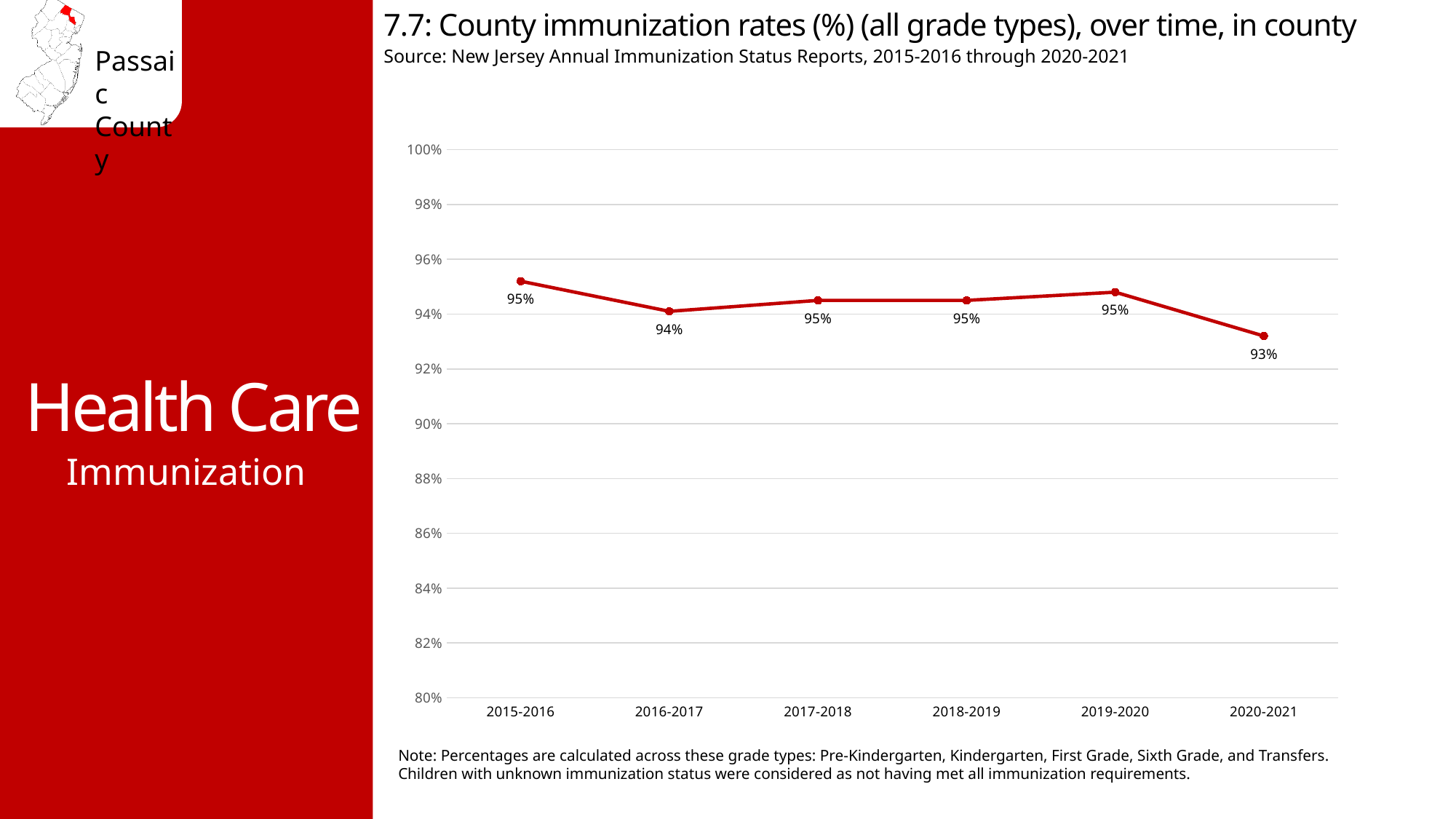
What is the county immunization rate for 2015-2016? 95% What is the source cited for the chart data? New Jersey Annual Immunization Status Reports, 2015-2016 through 2020-2021 How many school years are plotted on the chart? 6 Which school year has the lowest immunization rate? 2020-2021 What is the county immunization rate for 2018-2019? 95% Which year has a higher immunization rate, 2016-2017 or 2020-2021? 2016-2017 What is the difference in percentage points between the 2015-2016 rate and the 2020-2021 rate? 2 percentage points What is the county immunization rate for 2016-2017? 94% What is the county immunization rate for 2020-2021? 93% Does the immunization rate rise or fall from 2019-2020 to 2020-2021? Fall Is the value for 2020-2021 greater or less than 90%? greater What kind of chart is shown on the slide? Line chart